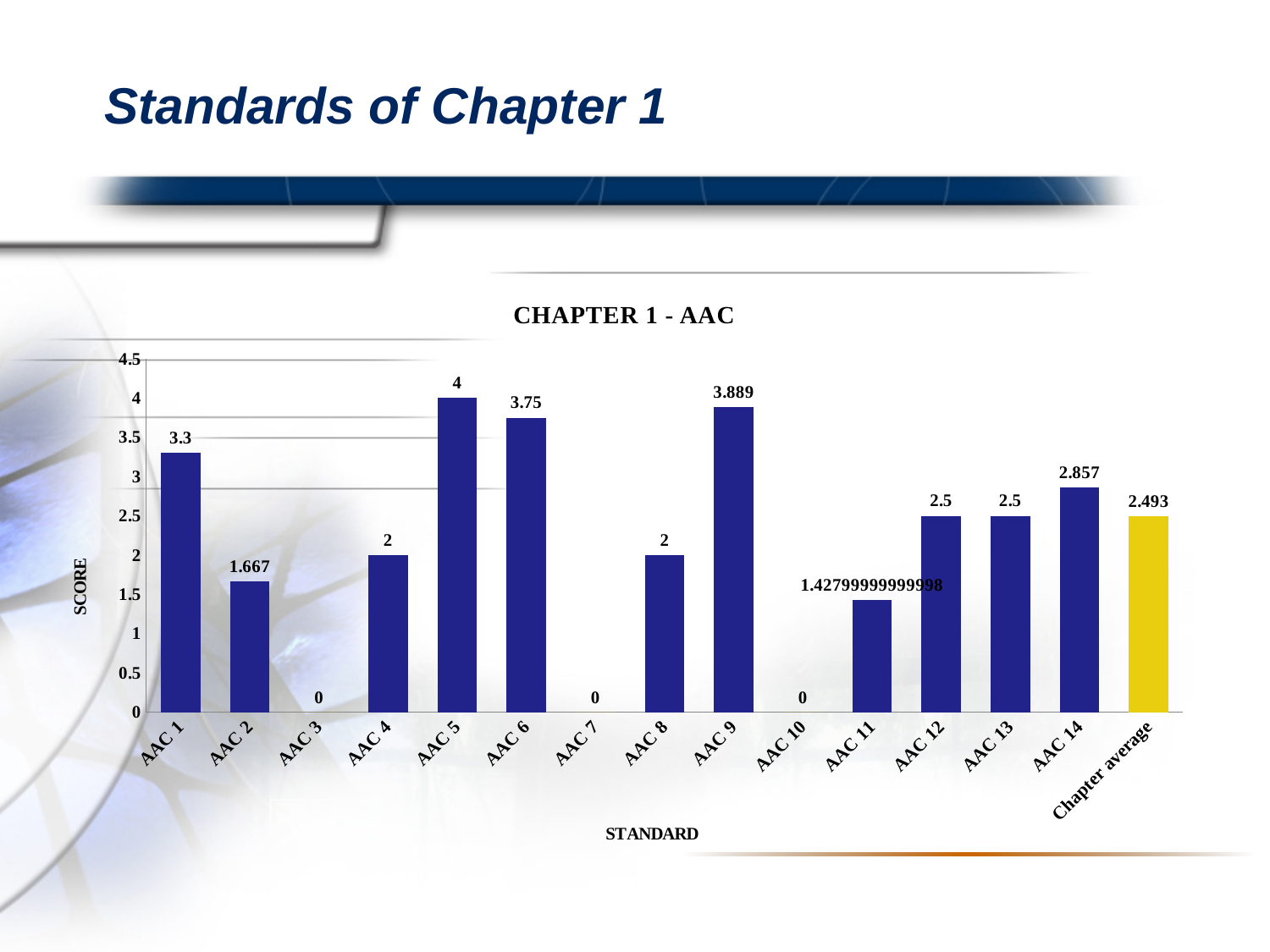
What is the difference between the scores for AAC 14 and AAC 12? 0.357 What is the value of the Chapter average bar? 2.493 What is the score for AAC 1? 3.3 How many categories are shown on the x axis? 15 Is the value for AAC 11 greater or less than 1.5? less What is the difference between the scores for AAC 5 and AAC 6? 0.25 What kind of chart is shown on the slide? Bar chart Which has a higher score, AAC 9 or AAC 6? AAC 9 What is the score for AAC 9? 3.889 What is the score for AAC 2? 1.667 What is the title of the chart? CHAPTER 1 - AAC Which standard has the highest score? AAC 5